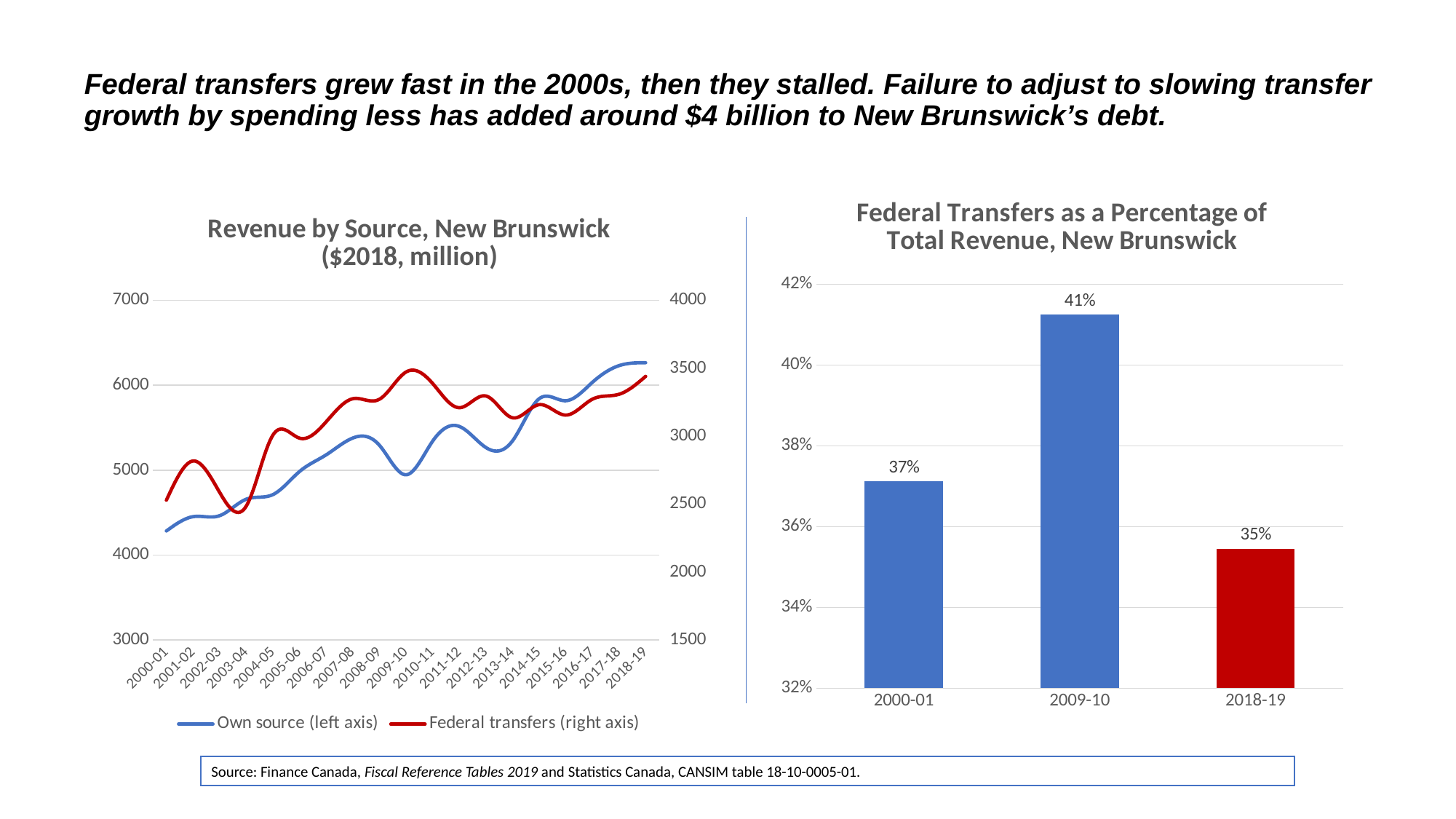
In the 'Federal Transfers as a Percentage of Total Revenue, New Brunswick' chart, which year has the lowest value? 2018-19 In the 'Revenue by Source, New Brunswick ($2018, million)' chart, is the Own source value for 2018-19 greater or less than 6000? greater In the 'Federal Transfers as a Percentage of Total Revenue, New Brunswick' chart, what colour is the 2018-19 bar? Red In the 'Federal Transfers as a Percentage of Total Revenue, New Brunswick' chart, what is the difference between the 2009-10 and 2018-19 values? 6 percentage points In the 'Federal Transfers as a Percentage of Total Revenue, New Brunswick' chart, which is larger, the value for 2000-01 or for 2018-19? 2000-01 In the 'Federal Transfers as a Percentage of Total Revenue, New Brunswick' chart, which year has the highest value? 2009-10 In the 'Federal Transfers as a Percentage of Total Revenue, New Brunswick' chart, what is the value for 2009-10? 41% In the 'Revenue by Source, New Brunswick ($2018, million)' chart, does the Own source series generally rise or fall from 2000-01 to 2018-19? Rise How many series does the legend of the 'Revenue by Source, New Brunswick ($2018, million)' chart list? 2 In the 'Federal Transfers as a Percentage of Total Revenue, New Brunswick' chart, what is the value for 2018-19? 35% What kind of chart is 'Revenue by Source, New Brunswick ($2018, million)'? Line chart How many bars are in the 'Federal Transfers as a Percentage of Total Revenue, New Brunswick' chart? 3